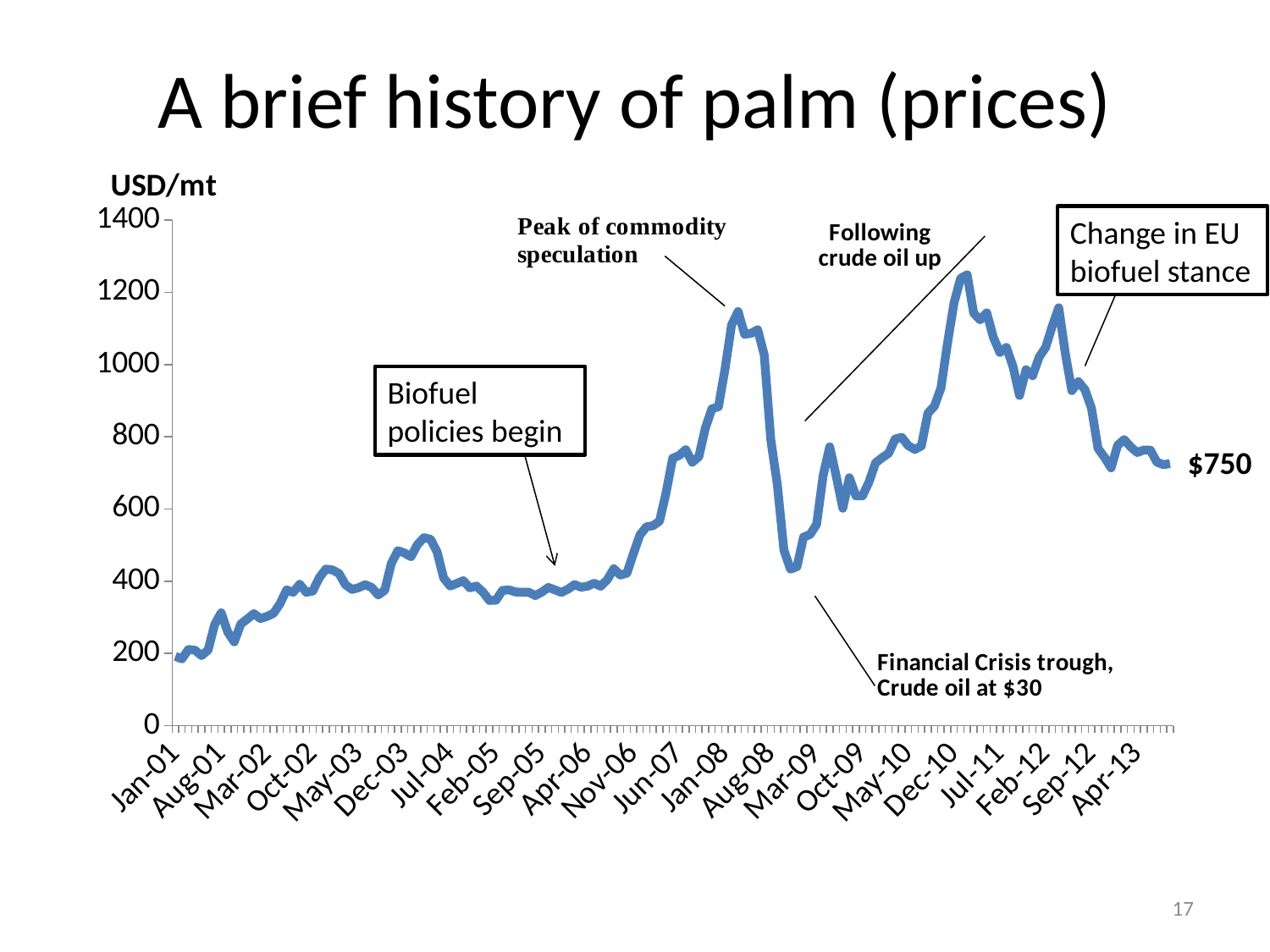
What kind of chart is shown on the slide? line chart Which is higher: the peak around Jan-08 or the peak around Dec-10? the peak around Dec-10 Is the value at Jan-01 greater or less than 400? less Is the peak value around Dec-10 greater or less than 1000? greater What unit is the vertical axis of the chart labelled with? USD/mt Does the price generally rise or fall between Jan-01 and Jan-08? rise Does the price generally rise or fall between Feb-12 and Apr-13? fall Is the value at the trough around Mar-09 greater or less than 600? less What value is printed as the data label at the end of the line (around Apr-13)? $750 What is the title of the chart on the slide? A brief history of palm (prices)